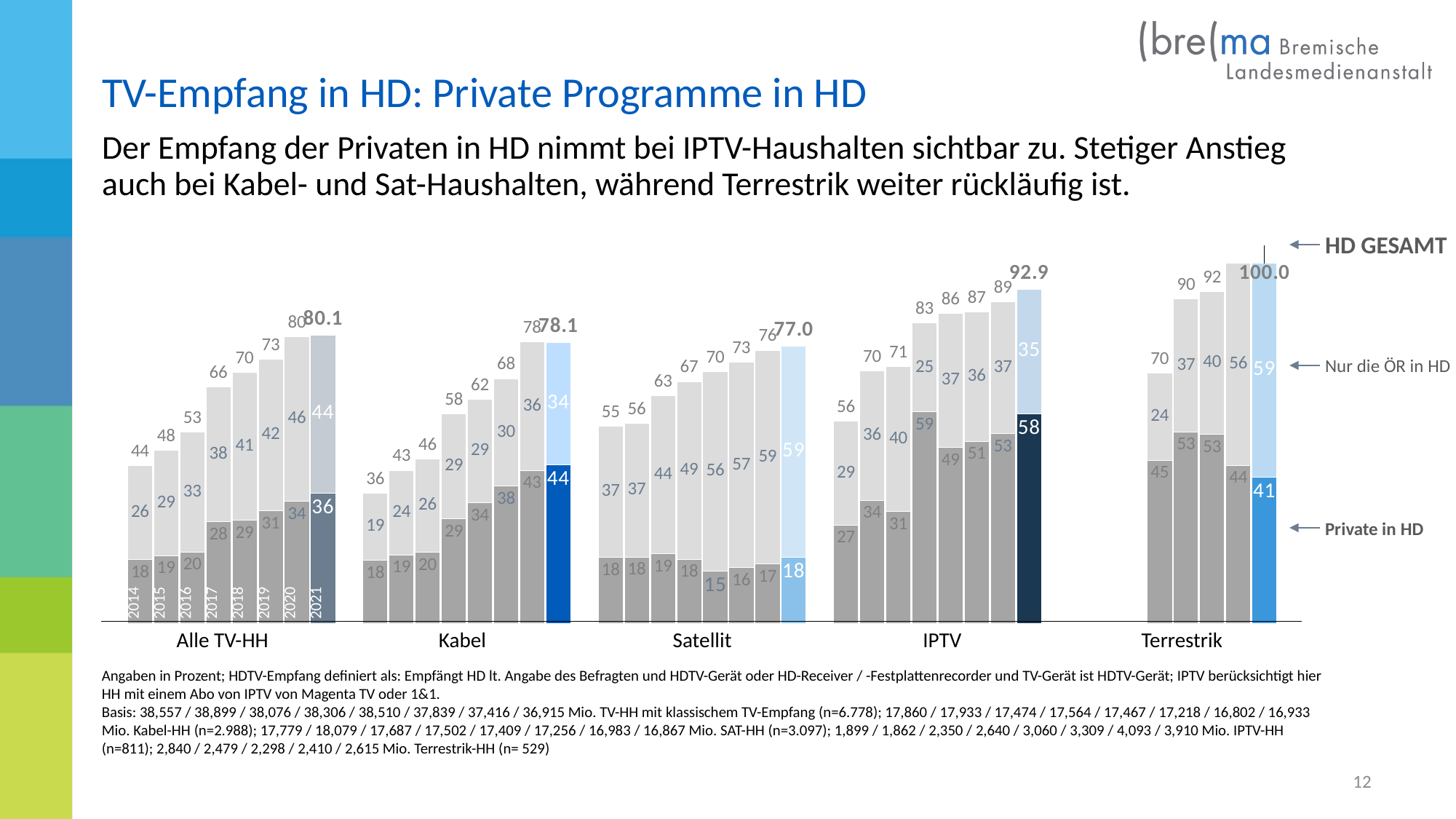
What kind of chart is shown on the slide? Stacked bar chart How many reception groups are shown on the x axis? 5 What is the total of the stacked bar for Alle TV-HH in 2020 (Private in HD plus Nur die ÖR in HD)? 80 What is the 'Private in HD' value for Terrestrik in 2021? 41 What is the difference between the 'Private in HD' values for IPTV and Satellit in 2021? 40 In 2021, is the 'Private in HD' value larger for Kabel or for Alle TV-HH? Kabel Which reception group has the highest 'HD GESAMT' value in 2021? Terrestrik What is the 'Private in HD' value for IPTV in 2021? 58 What is the 'HD GESAMT' value for Kabel in 2021? 78.1 Does the 'Private in HD' value for Kabel rise or fall from 2014 to 2021? Rise What is the 'Nur die ÖR in HD' value for Satellit in 2021? 59 Which reception group has the lowest 'Private in HD' value in 2021? Satellit